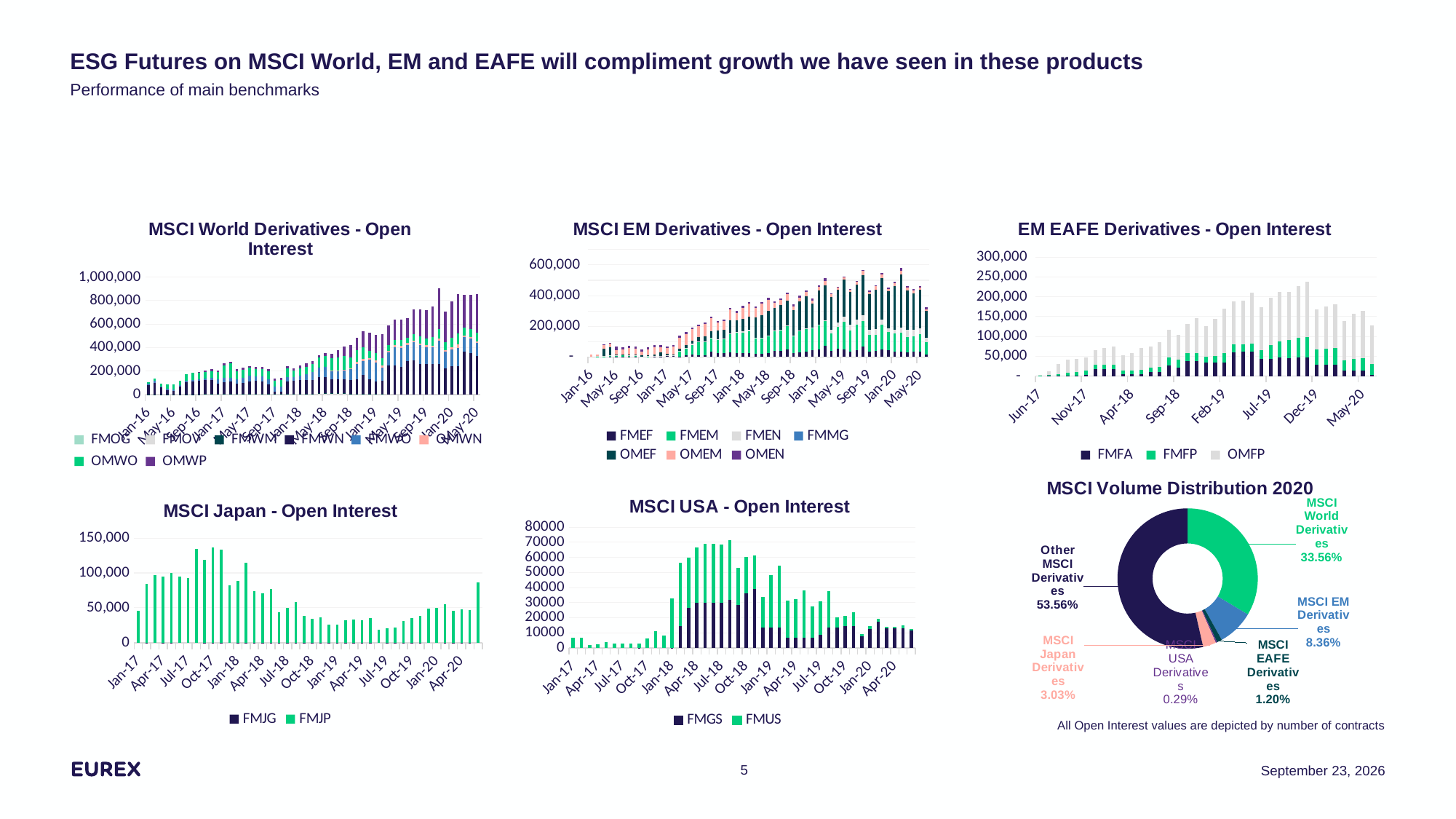
In the MSCI Volume Distribution 2020 chart, how many percentage points larger is the Other MSCI Derivatives share than the MSCI World Derivatives share? 20.00 percentage points How many categories are shown in the MSCI Volume Distribution 2020 chart? 6 In the MSCI Volume Distribution 2020 chart, which category has the largest share? Other MSCI Derivatives In the MSCI Volume Distribution 2020 chart, which category has the smallest share? MSCI USA Derivatives How many series does the legend of the MSCI EM Derivatives - Open Interest chart list? 7 How many series does the legend of the MSCI World Derivatives - Open Interest chart list? 8 In the MSCI EM Derivatives - Open Interest chart, do the total open interest values generally rise or fall from Jan-16 to Jan-19? rise In the MSCI Volume Distribution 2020 chart, what share of volume is attributed to MSCI World Derivatives? 33.56% In the MSCI World Derivatives - Open Interest chart, is the total value for May-20 greater or less than 600,000? greater In the MSCI Volume Distribution 2020 chart, which is larger: the MSCI EM Derivatives share or the MSCI EAFE Derivatives share? MSCI EM Derivatives How many series does the legend of the EM EAFE Derivatives - Open Interest chart list? 3 What kind of chart is the MSCI Volume Distribution 2020 chart? Doughnut chart